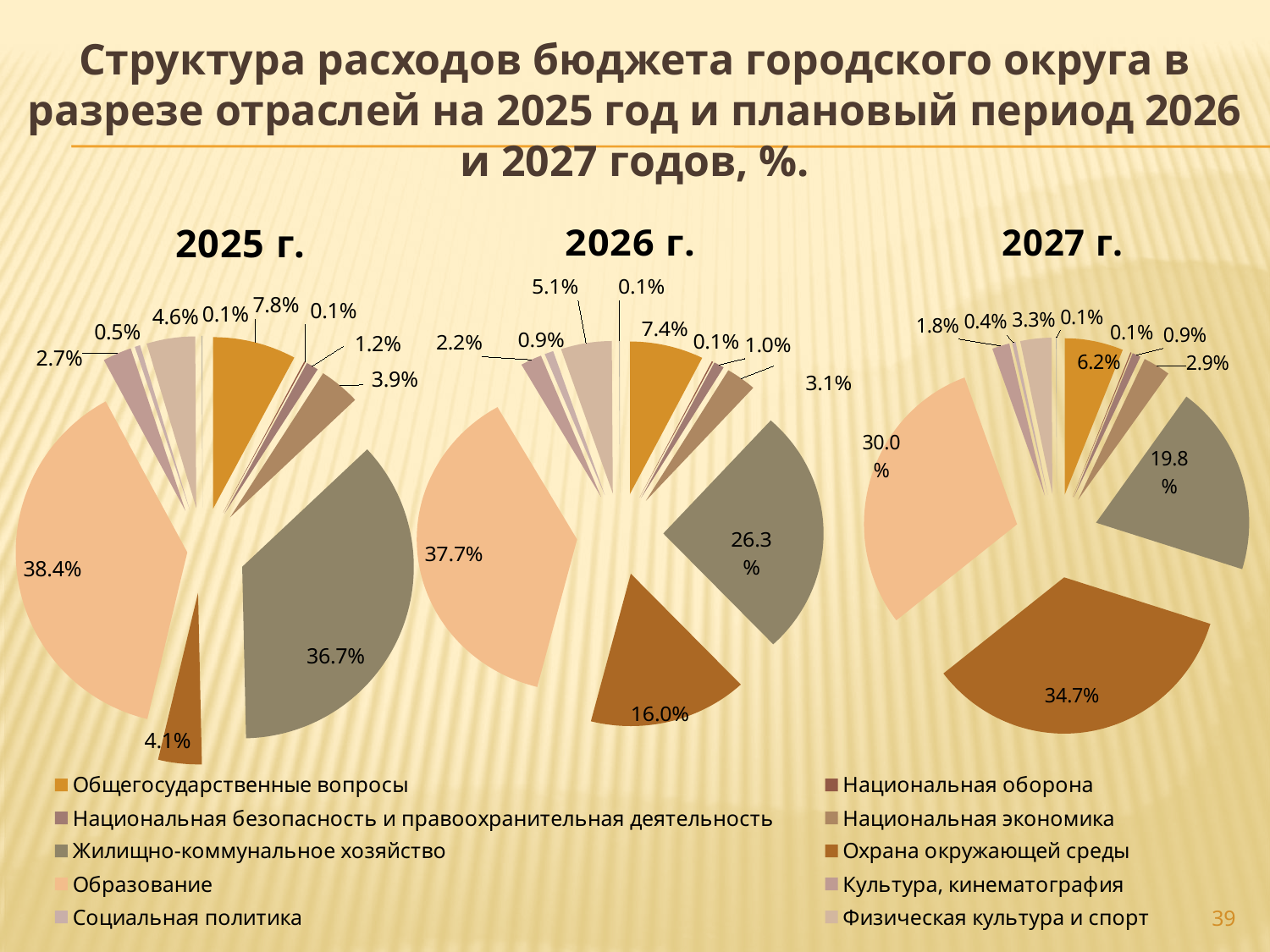
In the 2025 г. pie chart, what is the difference between the shares of Образование and Жилищно-коммунальное хозяйство? 1.7% Across the 2025, 2026 and 2027 pie charts, does the share of Охрана окружающей среды rise or fall? Rises What kind of chart is used on this slide for each year? Pie chart In the 2025 г. pie chart, what share is shown for Жилищно-коммунальное хозяйство? 36.7% In the 2025 г. pie chart, what share is shown for Образование? 38.4% In the 2027 г. pie chart, which category has the largest share? Охрана окружающей среды In the 2027 г. pie chart, what share is shown for Образование? 30.0% How many categories does the legend list? 10 How many pie charts are shown on the slide? 3 In the 2025 г. pie chart, which category has the largest share? Образование In the 2026 г. pie chart, which is larger: the share of Образование or the share of Жилищно-коммунальное хозяйство? Образование In the 2026 г. pie chart, what share is shown for Охрана окружающей среды? 16.0%